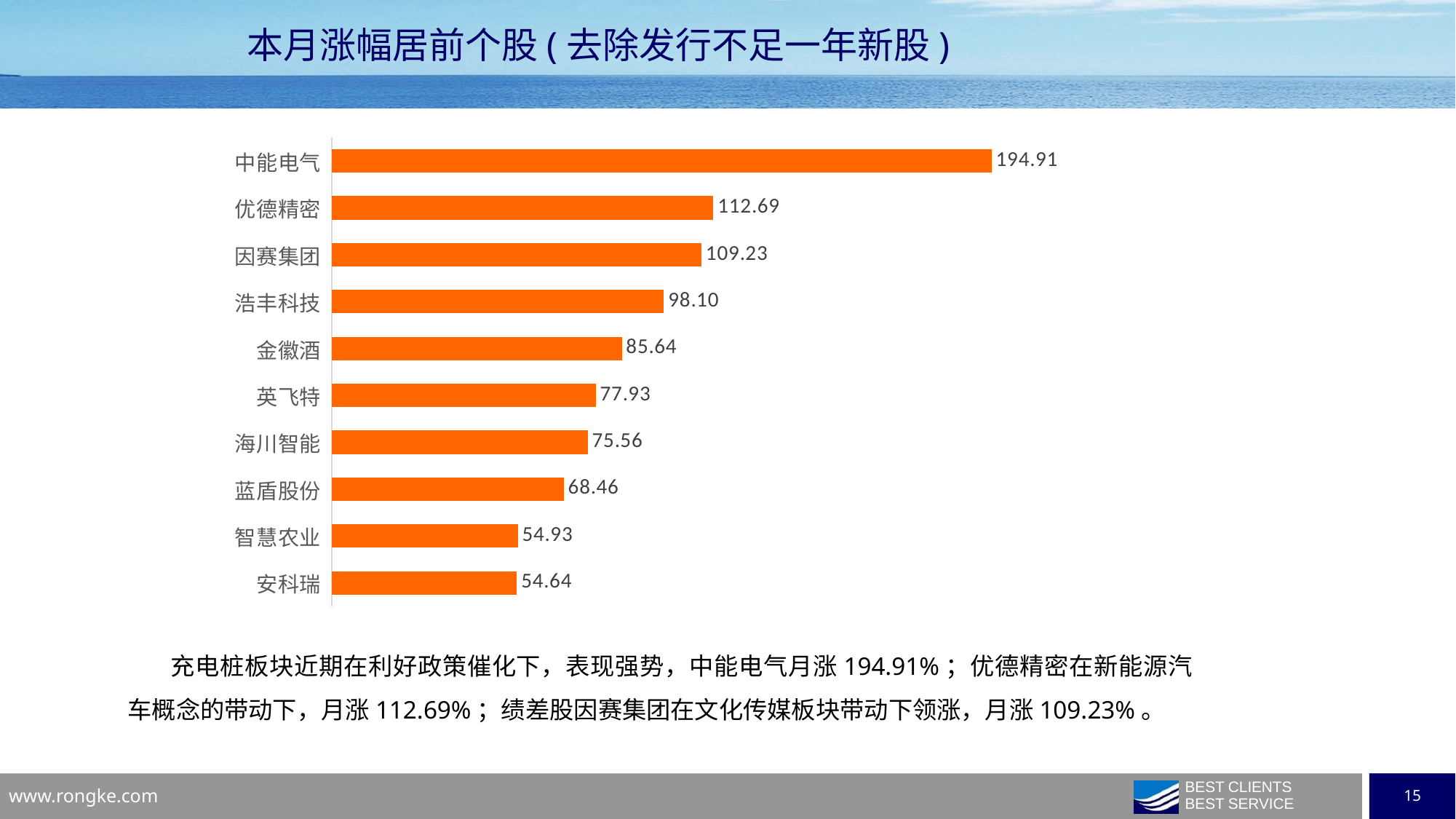
What colour are the bars in the chart? Orange Which stock has the highest value in the chart? 中能电气 What is the value shown for 中能电气? 194.91 What is the value shown for 浩丰科技? 98.10 What is the difference between the values for 优德精密 and 因赛集团? 3.46 What kind of chart is shown on the slide? Bar chart What is the difference between the values for 中能电气 and 金徽酒? 109.27 Which has a larger value, 英飞特 or 海川智能? 英飞特 Which stock has the lowest value in the chart? 安科瑞 How many stocks are shown in the chart? 10 Which has a larger value, 智慧农业 or 蓝盾股份? 蓝盾股份 What is the value shown for 蓝盾股份? 68.46